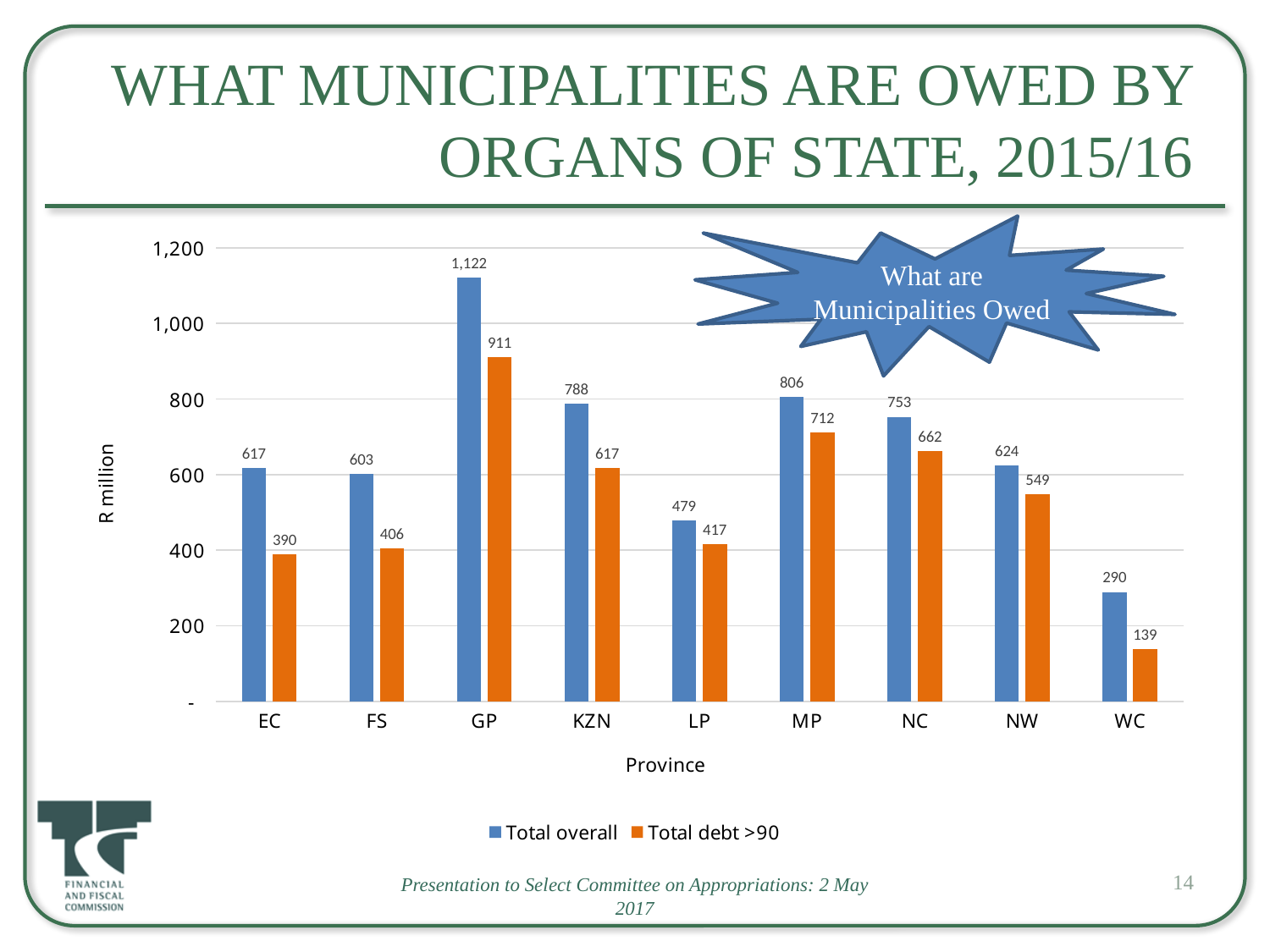
What is the label of the y axis? R million Is the Total overall value for LP greater or less than 400? greater How many series does the legend list? 2 What is the Total debt >90 value for NC? 662 What is the Total debt >90 value for WC? 139 What kind of chart is shown on the slide? bar chart What is the difference between the Total overall and Total debt >90 values for EC? 227 Which is larger, the Total overall value for MP or for NC? MP Which province has the lowest Total debt >90 value? WC What is the Total overall value for GP? 1,122 How many provinces are shown on the x axis? 9 Which province has the highest Total overall value? GP